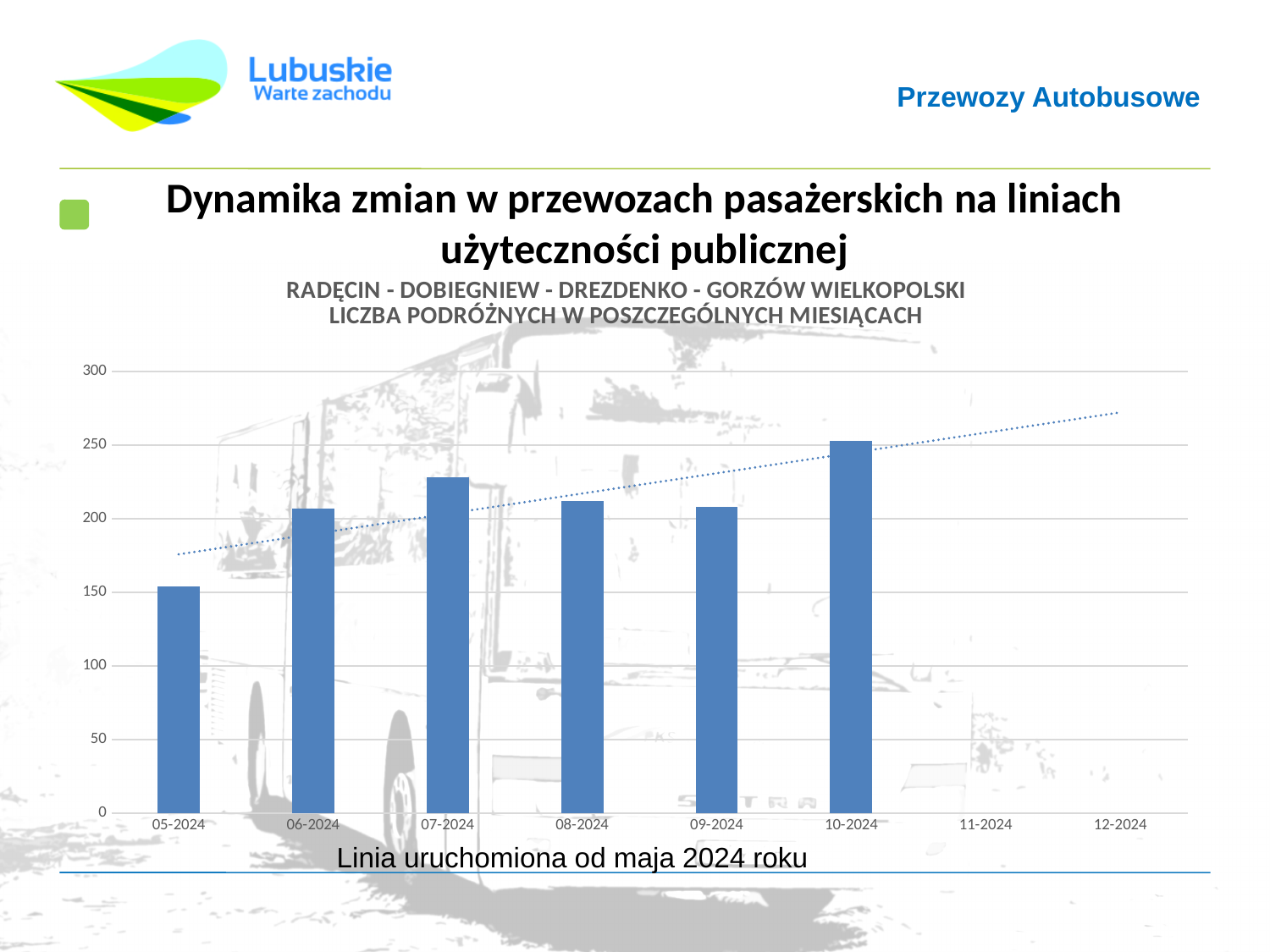
Which route is named in the chart subtitle? RADĘCIN - DOBIEGNIEW - DREZDENKO - GORZÓW WIELKOPOLSKI Which is larger, the value for 07-2024 or the value for 06-2024? 07-2024 What kind of chart is shown on the slide? bar chart Which month has the lowest number of passengers? 05-2024 Is the value for 07-2024 greater or less than 200? greater Does the dotted trend line rise or fall from left to right? rise Is the value for 05-2024 greater or less than 200? less Which is larger, the value for 10-2024 or the value for 08-2024? 10-2024 Which month has the highest number of passengers? 10-2024 How many months have a bar plotted on the chart? 6 Is the value for 06-2024 greater or less than 250? less